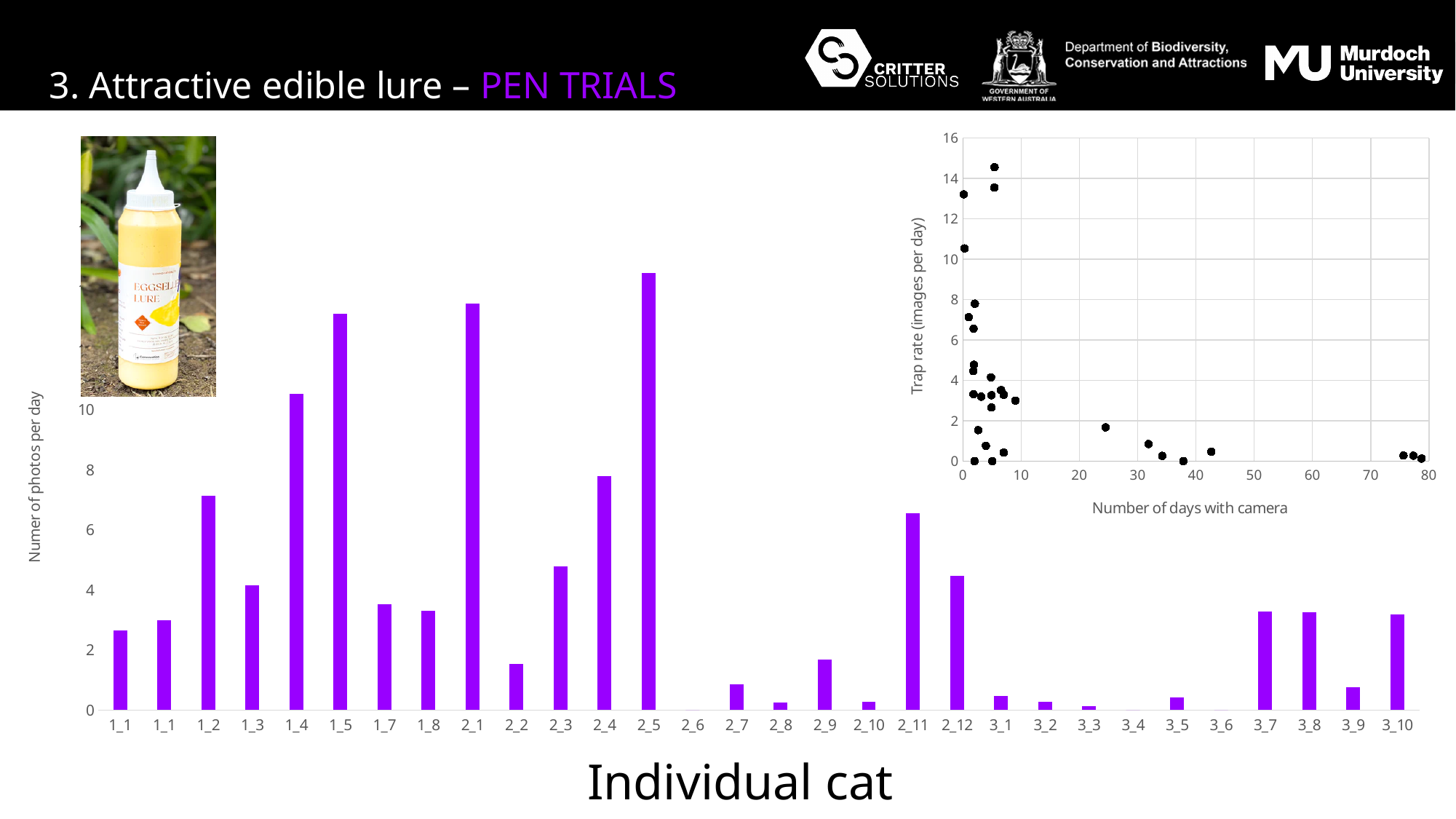
In the bar chart of photos per day by individual cat, which cat has the highest number of photos per day? 2_5 In the bar chart of photos per day by individual cat, which has more photos per day, cat 1_4 or cat 2_4? 1_4 What kind of chart is the large chart on the left of the slide, with 'Individual cat' on the x axis? bar chart In the scatter chart in the top right, what is the label of the y axis? Trap rate (images per day) In the bar chart of photos per day by individual cat, is the value for cat 2_2 greater or less than 2? less In the bar chart of photos per day by individual cat, which has more photos per day, cat 2_11 or cat 2_12? 2_11 In the bar chart of photos per day by individual cat, is the value for cat 1_5 greater or less than 10? greater In the bar chart of photos per day by individual cat, is the value for cat 1_2 greater or less than 6? greater In the bar chart of photos per day by individual cat, how many cat categories are shown on the x axis? 30 What kind of chart is the smaller chart in the top right, with 'Number of days with camera' on the x axis? scatter chart In the bar chart of photos per day by individual cat, what is the label of the y axis? Numer of photos per day In the scatter chart of trap rate against number of days with camera, does the trap rate generally rise or fall as the number of days with camera increases? fall